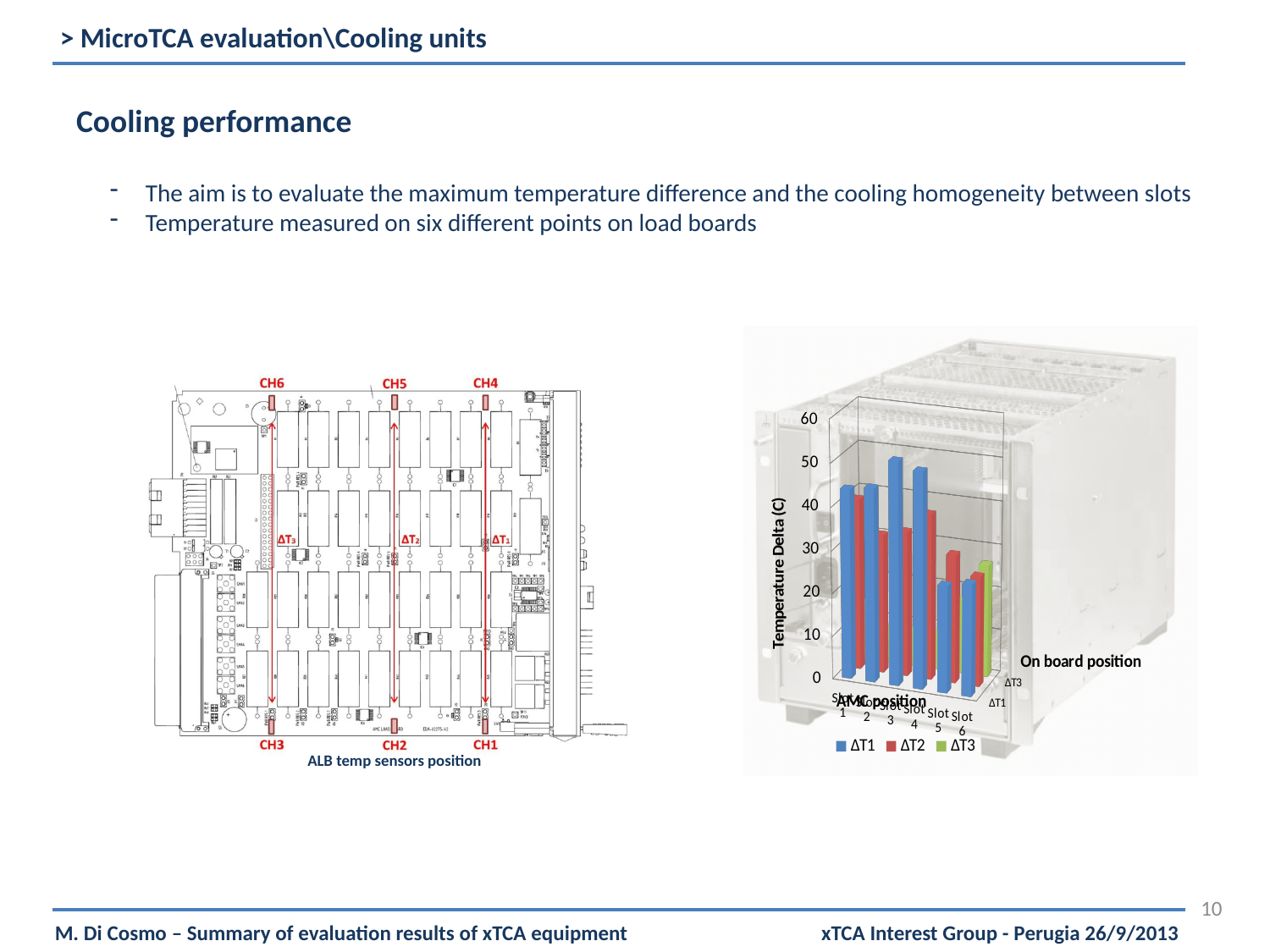
What is the title of the vertical axis of the chart? Temperature Delta (C) How many slot positions are shown along the AMC position axis of the chart? 6 Which is larger, the ΔT1 value for Slot 4 or the ΔT1 value for Slot 6? Slot 4 Which is larger, the ΔT1 value for Slot 3 or the ΔT1 value for Slot 5? Slot 3 Is the ΔT1 value for Slot 1 greater or less than 30? greater What is the highest value shown on the vertical axis of the chart? 60 Is the ΔT2 value for Slot 6 greater or less than 40? less Is the ΔT1 value for Slot 3 greater or less than 40? greater Which colour represents the ΔT2 series in the chart? red What kind of chart is shown on the slide? bar chart How many series does the chart legend list? 3